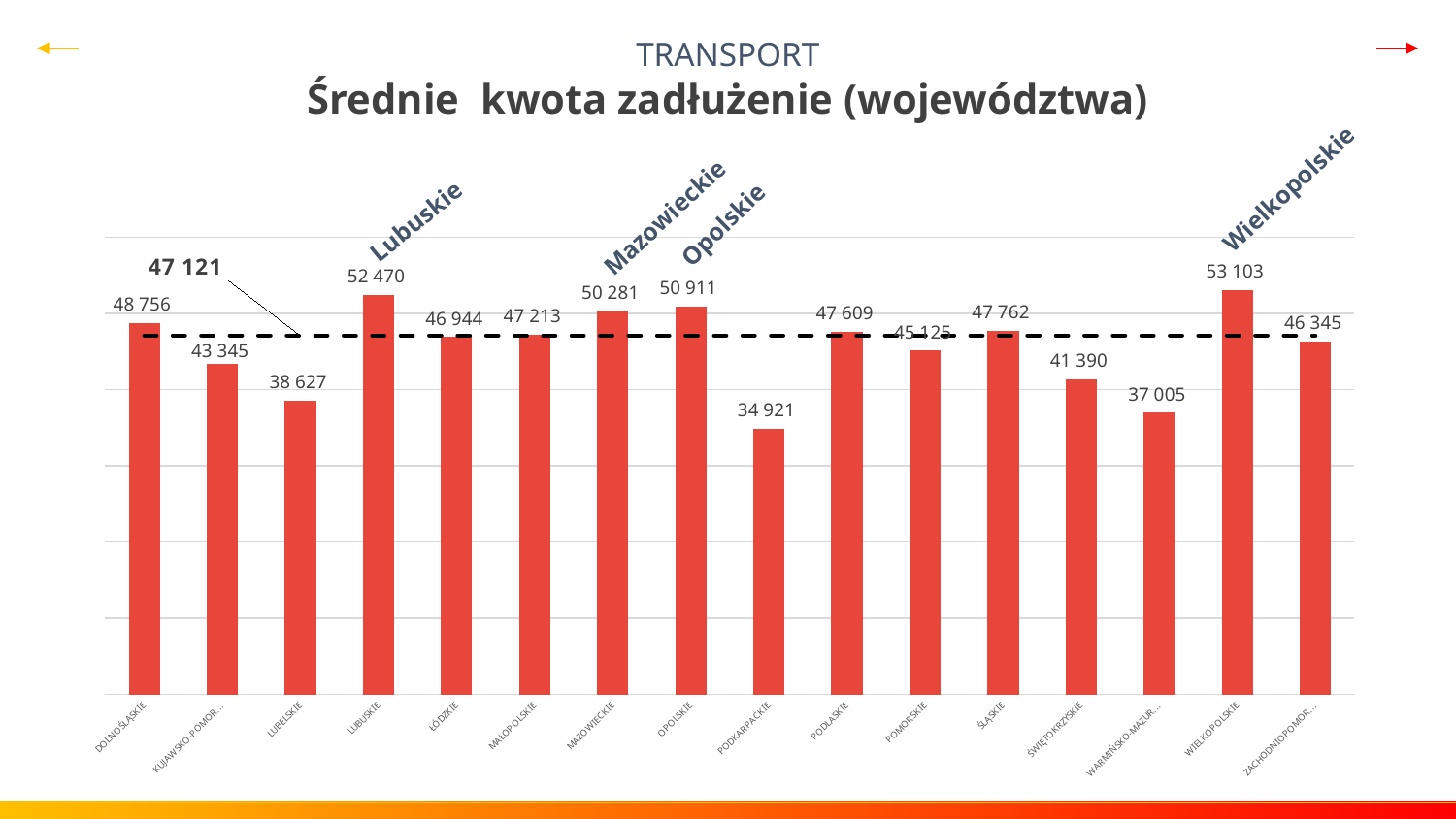
What is the value for Lubuskie? 52 470 What is the difference between the values for Lubuskie and Lubelskie? 13 843 What value is marked by the dashed horizontal line across the chart? 47 121 Which is larger, the value for Świętokrzyskie or the value for Pomorskie? Pomorskie Which is larger, the value for Mazowieckie or the value for Opolskie? Opolskie Which voivodeship has the highest value? Wielkopolskie What is the value for Opolskie? 50 911 What is the difference between the values for Wielkopolskie and Podkarpackie? 18 182 What is the value for Podkarpackie? 34 921 How many bars (voivodeships) are shown in the chart? 16 Which voivodeship has the lowest value? Podkarpackie What type of chart is shown on the slide? bar chart